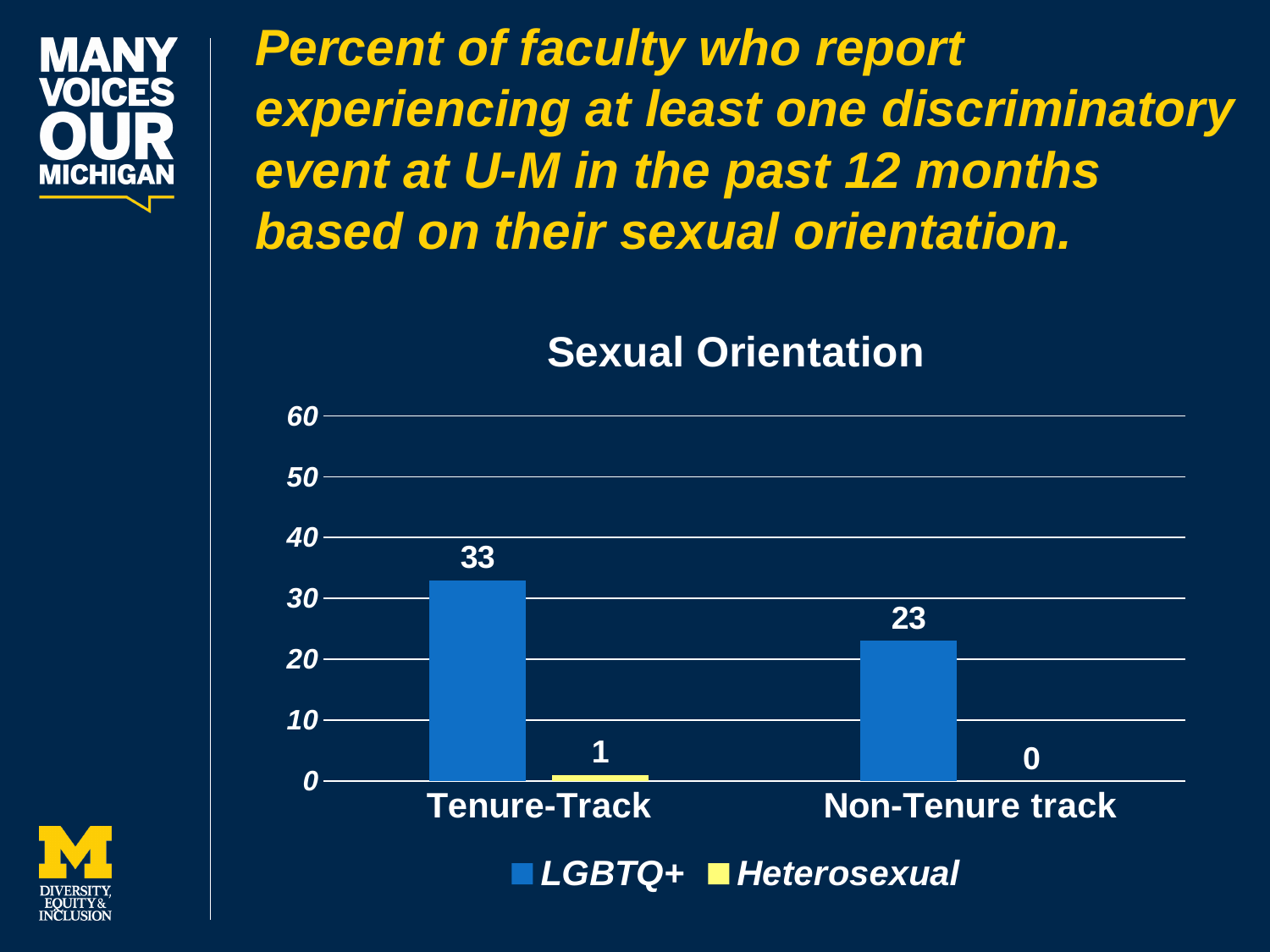
Which is larger: the LGBTQ+ value for Non-Tenure track or the Heterosexual value for Tenure-Track? LGBTQ+ value for Non-Tenure track Is the LGBTQ+ value for Tenure-Track greater or less than 30? greater In the Tenure-Track category, what is the difference between the LGBTQ+ and Heterosexual values? 32 What is the value for Heterosexual faculty in the Non-Tenure track category? 0 What is the value for LGBTQ+ faculty in the Tenure-Track category? 33 What is the value for Heterosexual faculty in the Tenure-Track category? 1 Which category has the higher value for LGBTQ+ faculty? Tenure-Track What is the difference between the LGBTQ+ values for Tenure-Track and Non-Tenure track? 10 How many series does the legend list? 2 What kind of chart is shown on the slide? Bar chart What is the value for LGBTQ+ faculty in the Non-Tenure track category? 23 How many categories are shown on the x axis? 2